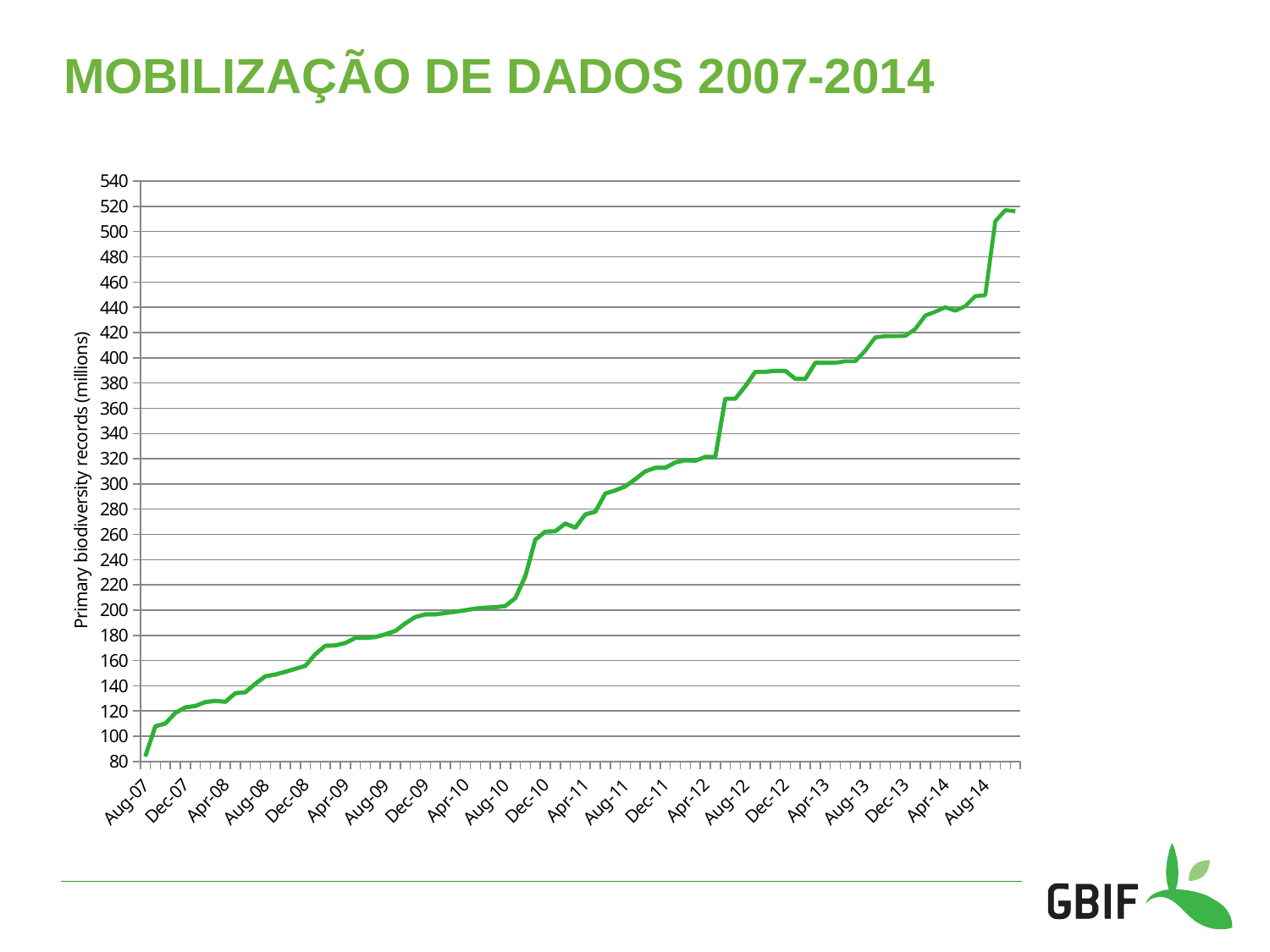
What is the title of the slide? MOBILIZAÇÃO DE DADOS 2007-2014 Is the value at Aug-09 greater or less than 200? less Is the value at Apr-14 greater or less than 420? greater Is the value at Dec-12 greater or less than 400? less What kind of chart is shown on the slide? line chart Do the values rise or fall from Aug-07 to Aug-14? rise Which x-axis label has the lowest value on the line? Aug-07 What is the label of the y axis? Primary biodiversity records (millions)